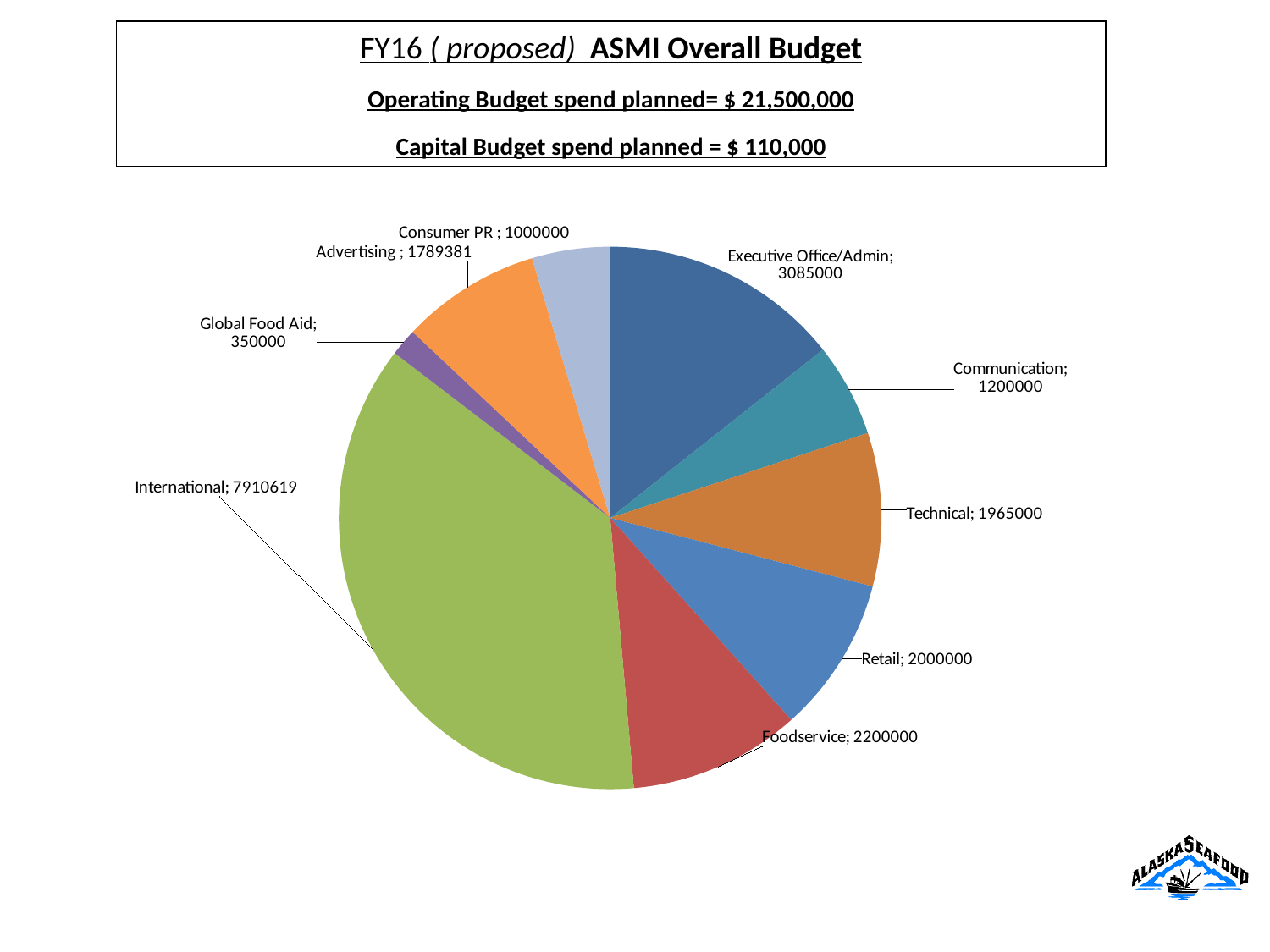
What is the value for International? 7910619 What is the value for Executive Office/Admin? 3085000 What is the value for Advertising? 1789381 What is the difference between the Technical and Communication values? 765000 What kind of chart is shown on the slide? pie chart How many slices does the pie chart have? 9 What is the difference between the Foodservice and Retail values? 200000 What is the value for Global Food Aid? 350000 What is the Operating Budget spend planned stated in the slide title box? $ 21,500,000 Which category has the smallest slice of the pie? Global Food Aid Which category has the largest slice of the pie? International Which is larger, Executive Office/Admin or Technical? Executive Office/Admin